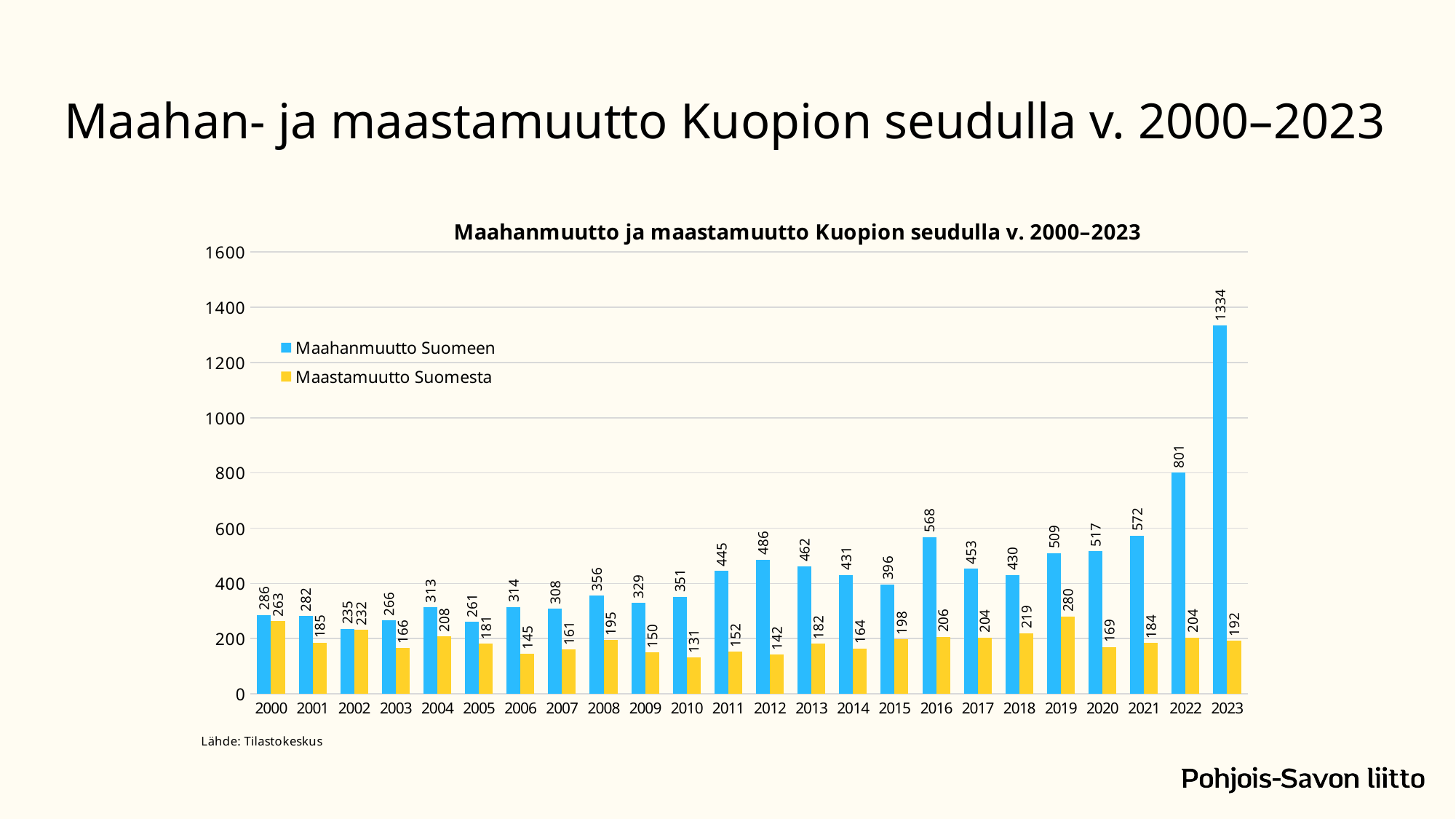
What is the value of Maahanmuutto Suomeen in 2023? 1334 Which year has the lowest value for Maastamuutto Suomesta? 2010 What is the value of Maastamuutto Suomesta in 2019? 280 What is the value of Maahanmuutto Suomeen in 2016? 568 Which year has the lowest value for Maahanmuutto Suomeen? 2002 How many series does the legend list? 2 Which year has the highest value for Maahanmuutto Suomeen? 2023 What is the difference between Maahanmuutto Suomeen in 2022 and in 2021? 229 What is the difference between Maahanmuutto Suomeen and Maastamuutto Suomesta in 2023? 1142 Which is larger in 2000: Maahanmuutto Suomeen or Maastamuutto Suomesta? Maahanmuutto Suomeen How many years are shown on the x axis of the chart? 24 What type of chart is shown on the slide? Bar chart